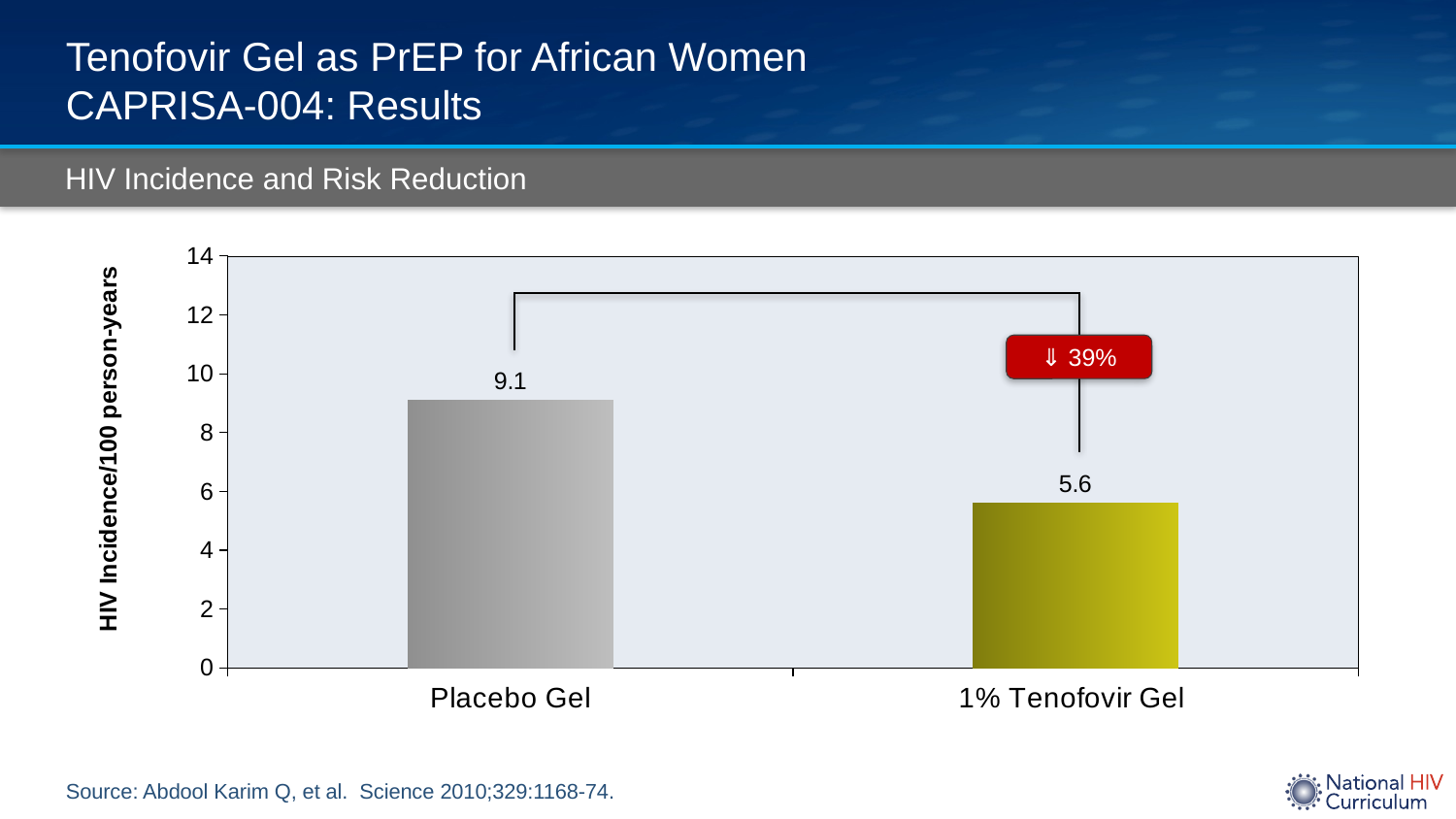
What percentage risk reduction is annotated on the chart? 39% Is the HIV incidence higher for Placebo Gel or for 1% Tenofovir Gel? Placebo Gel Which group has the lower HIV incidence? 1% Tenofovir Gel What is the HIV incidence per 100 person-years for the Placebo Gel group? 9.1 Is the value for 1% Tenofovir Gel greater or less than 6? less What is the HIV incidence per 100 person-years for the 1% Tenofovir Gel group? 5.6 Is the value for Placebo Gel greater or less than 8? greater What is the label of the y-axis? HIV Incidence/100 person-years What is the difference in HIV incidence between the Placebo Gel and 1% Tenofovir Gel groups? 3.5 How many groups are shown in the chart? 2 Which group has the higher HIV incidence? Placebo Gel What kind of chart is shown on the slide? Bar chart